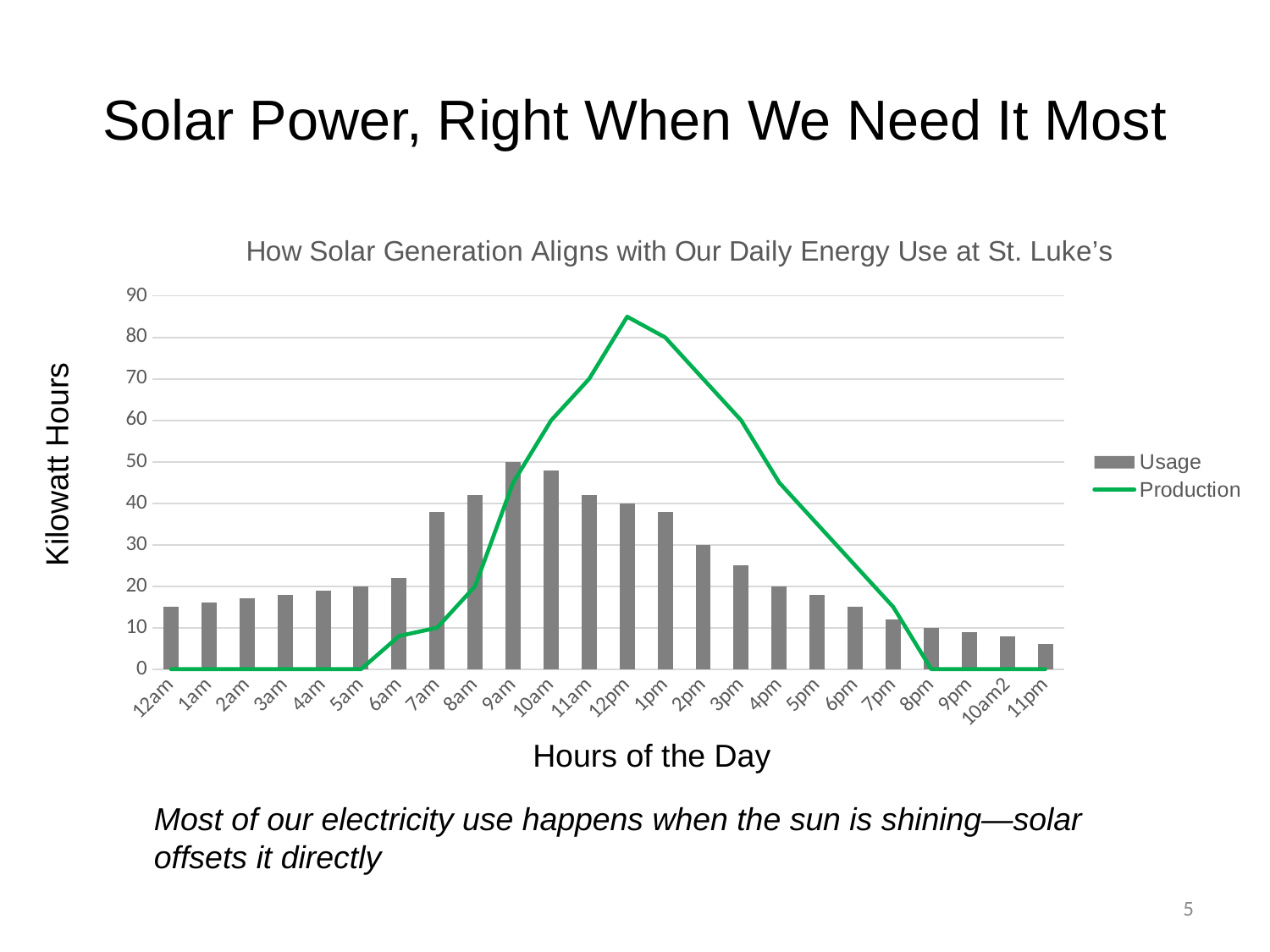
At which hour does Production peak? 12pm Which is larger at 12pm, Usage or Production? Production What is the Production value at 12am? 0 How many hours of the day are shown on the x axis? 24 Is the Usage value at 7am greater or less than 30? greater Is the Production value at 12pm greater or less than 80? greater Does Usage rise or fall from 9am to 11pm? Fall What is the title of the chart? How Solar Generation Aligns with Our Daily Energy Use at St. Luke's How many series does the legend list? 2 At which hour is Usage lowest? 11pm What kind of chart is this? Combined bar and line chart At which hour is Usage highest? 9am